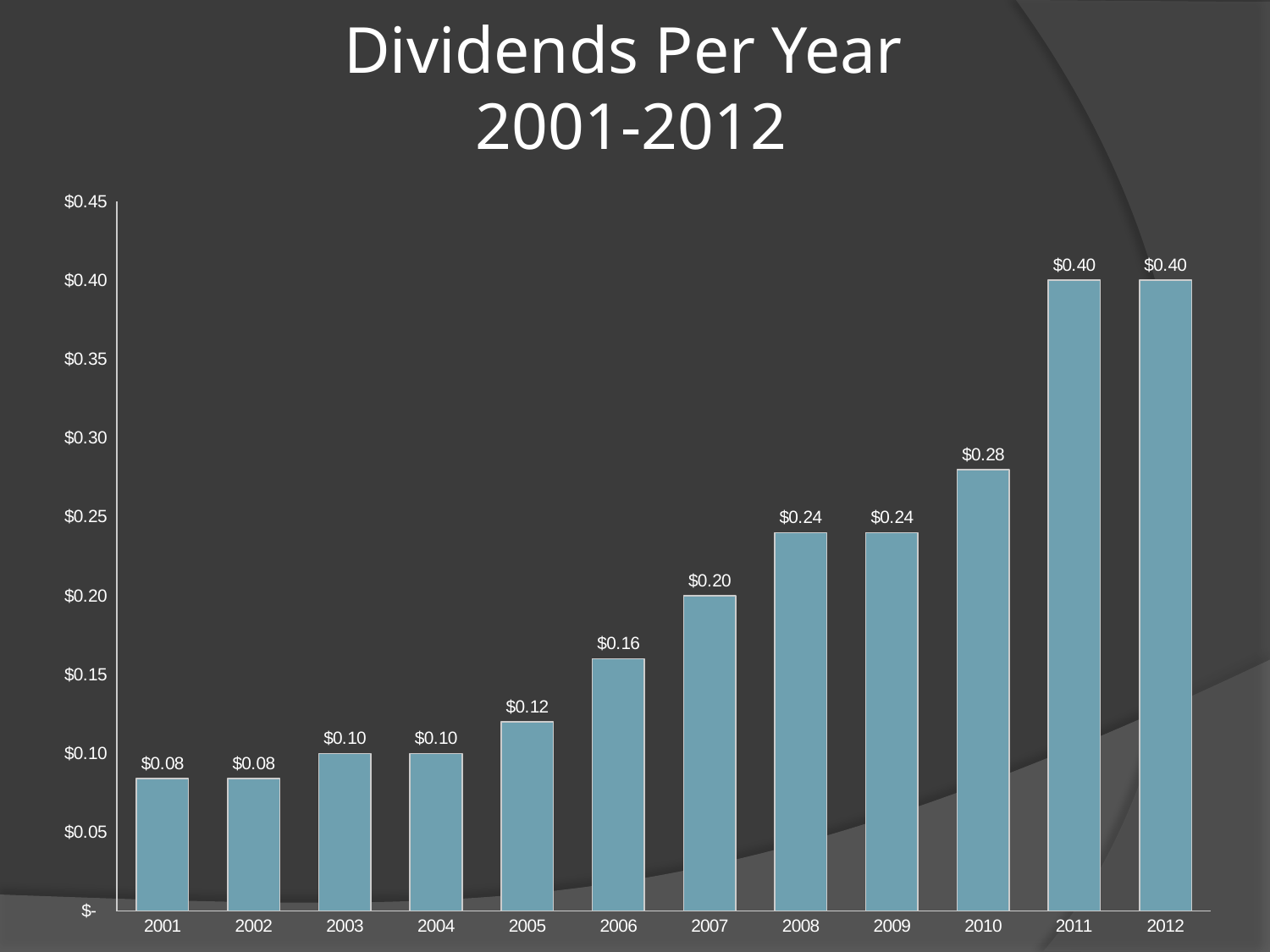
Is the dividend value for 2009 greater or less than $0.20? greater What is the dividend value for 2010? $0.28 What is the dividend value for 2001? $0.08 Which is larger, the dividend for 2008 or the dividend for 2006? 2008 How many years are shown on the x axis of the chart? 12 What is the highest dividend value shown on the chart? $0.40 What is the difference between the dividend in 2011 and the dividend in 2010? $0.12 Do the dividend values generally rise or fall from 2001 to 2012? Rise What is the difference between the dividend in 2006 and the dividend in 2005? $0.04 What is the dividend value for 2007? $0.20 What kind of chart is shown on the slide? Bar chart Which year has the lowest dividend value shown (earliest of the tied years)? 2001